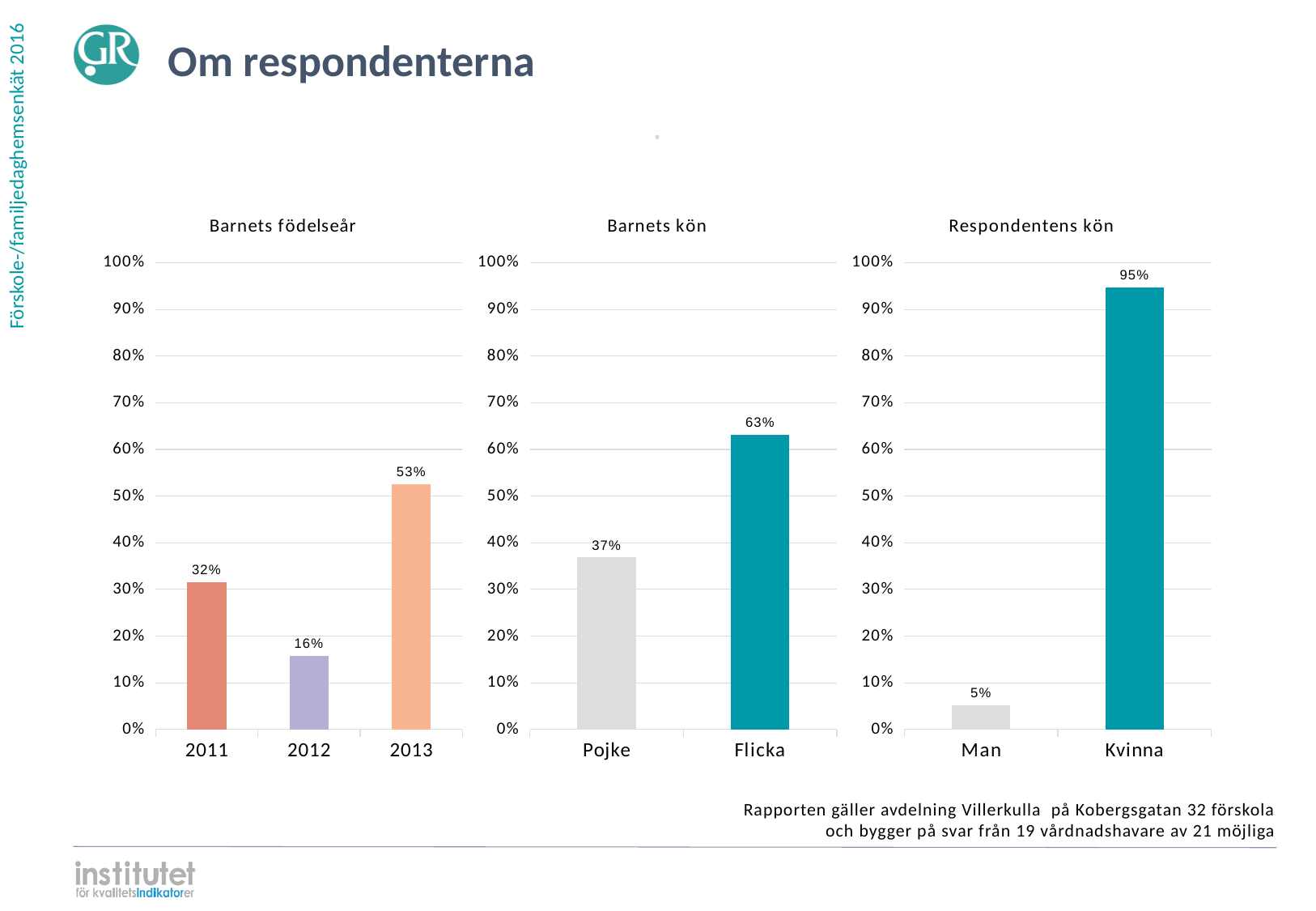
In the 'Barnets kön' chart, what is the value for Pojke? 37% How many charts are shown on the slide? 3 In the 'Barnets födelseår' chart, what is the value for 2013? 53% In the 'Barnets födelseår' chart, what is the difference between the values for 2013 and 2011? 21% In the 'Respondentens kön' chart, what is the value for Kvinna? 95% In the 'Respondentens kön' chart, is the value for Kvinna greater or less than 90%? greater In the 'Respondentens kön' chart, what is the value for Man? 5% What kind of chart is the 'Barnets födelseår' chart? Bar chart In the 'Barnets kön' chart, what is the difference between Flicka and Pojke? 26% In the 'Barnets kön' chart, which category is higher, Pojke or Flicka? Flicka In the 'Barnets födelseår' chart, which birth year has the lowest value? 2012 In the 'Barnets födelseår' chart, how many categories are shown on the x axis? 3